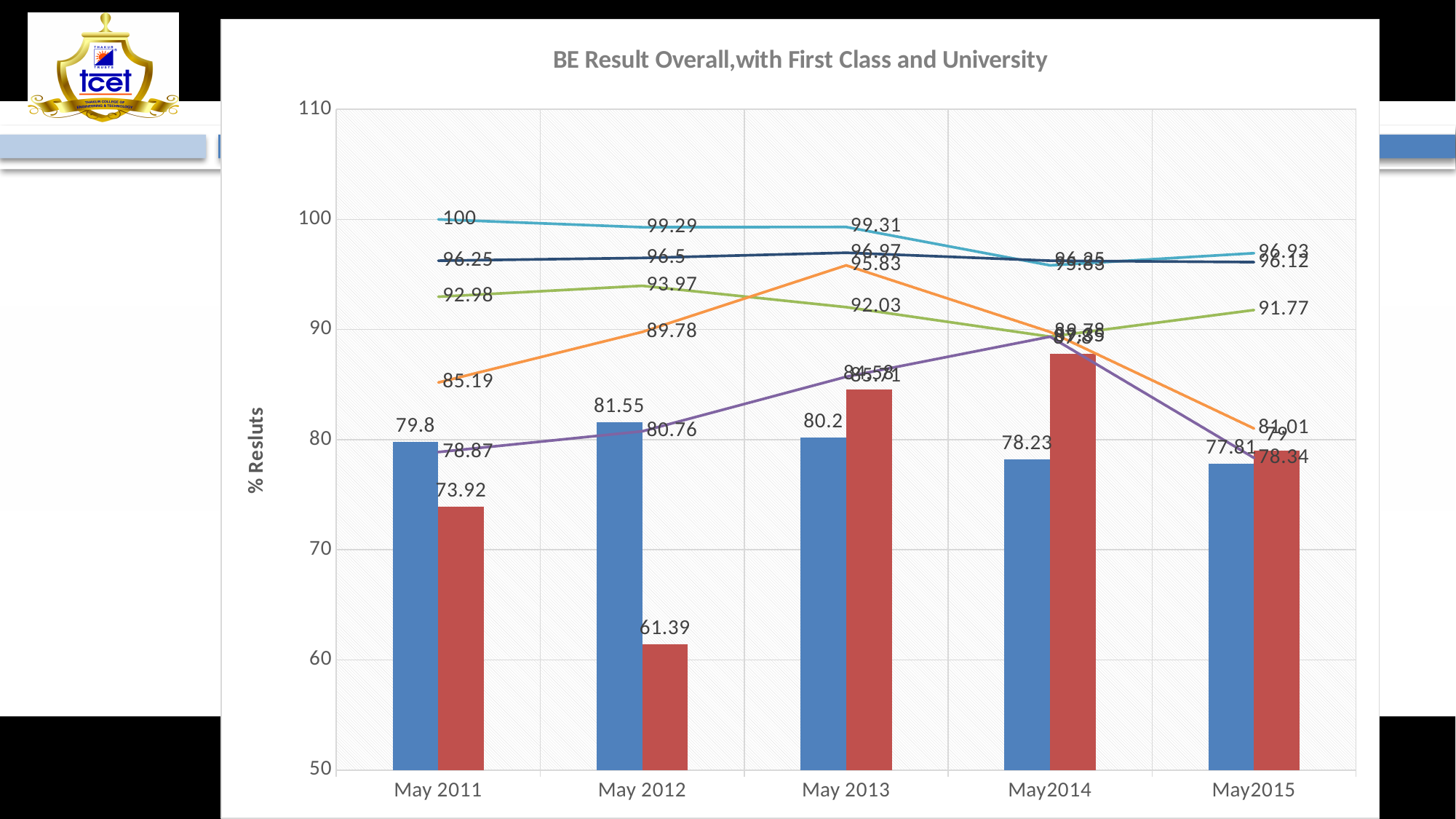
What is the value of the orange line at May 2013? 95.83 Which is larger for May 2011, the blue bar or the red bar? The blue bar Which category has the lowest red bar? May 2012 What type of chart is shown on the slide? Combined bar and line chart What is the title of the chart? BE Result Overall,with First Class and University What is the value of the red bar for May 2012? 61.39 What is the difference between the blue bar for May 2012 and the blue bar for May 2011? 1.75 What is the value of the blue bar for May 2012? 81.55 Do the blue bars rise or fall from May 2012 to May2015? Fall What is the value of the green line at May2015? 91.77 How many categories are shown on the x axis? 5 Which category has the highest blue bar? May 2012